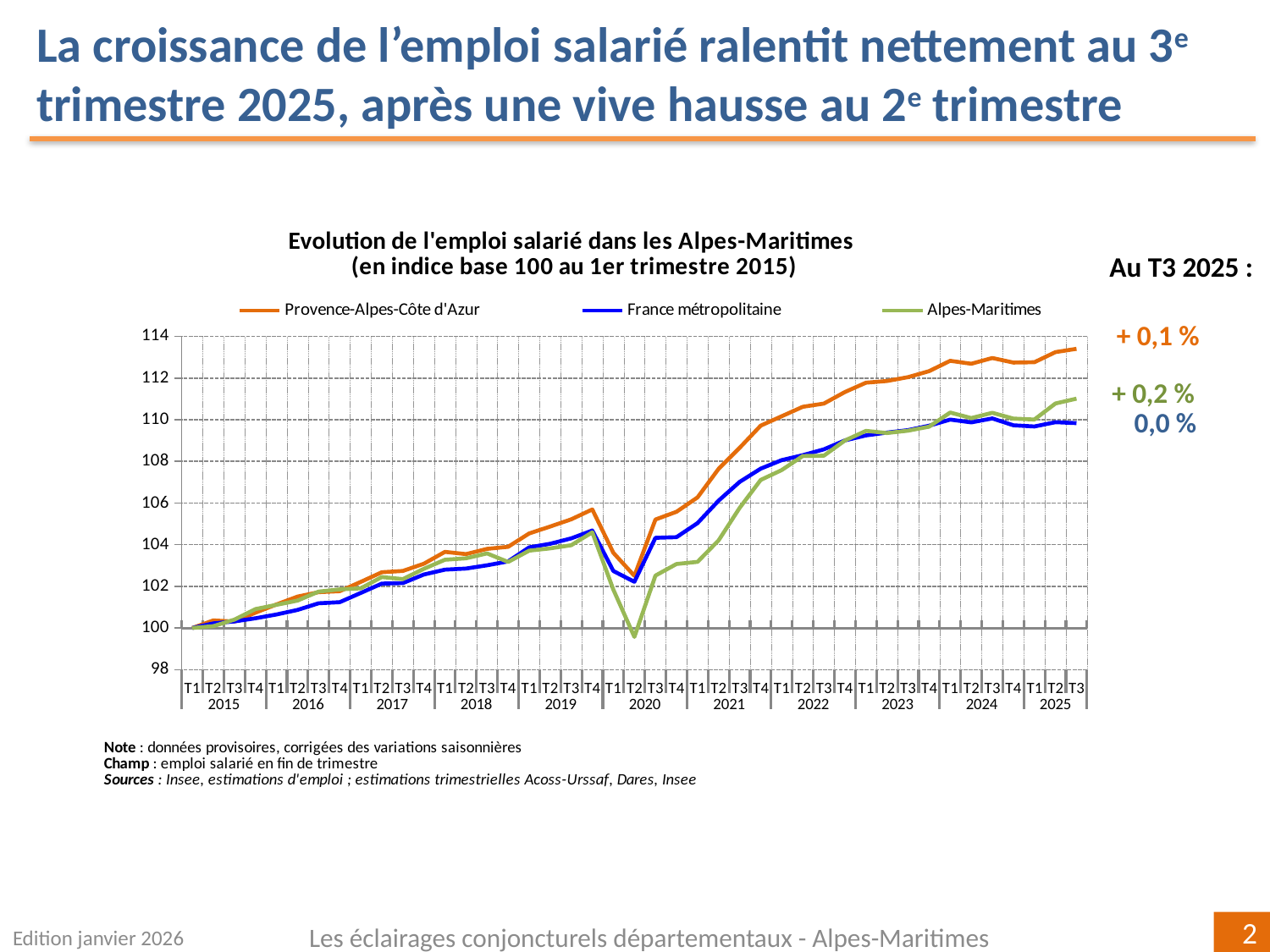
Which series has the highest index value at T3 2025? Provence-Alpes-Côte d'Azur What kind of chart is shown on the slide? line chart Which series are listed in the chart legend? Provence-Alpes-Côte d'Azur, France métropolitaine, Alpes-Maritimes Which series has the lowest index value at T2 2020? Alpes-Maritimes Is the index value for Provence-Alpes-Côte d'Azur at T3 2025 greater or less than 112? greater What is the title of the chart? Evolution de l'emploi salarié dans les Alpes-Maritimes (en indice base 100 au 1er trimestre 2015) At T3 2025, which has the larger annotated change: Alpes-Maritimes or Provence-Alpes-Côte d'Azur? Alpes-Maritimes According to the annotation, what is the change in salaried employment for Provence-Alpes-Côte d'Azur at T3 2025? + 0,1 % According to the annotation, what is the change in salaried employment for France métropolitaine at T3 2025? 0,0 % Overall, do the index values rise or fall from 2015 to 2025? rise According to the annotation, what is the change in salaried employment for Alpes-Maritimes at T3 2025? + 0,2 % How many series does the legend of the chart list? 3